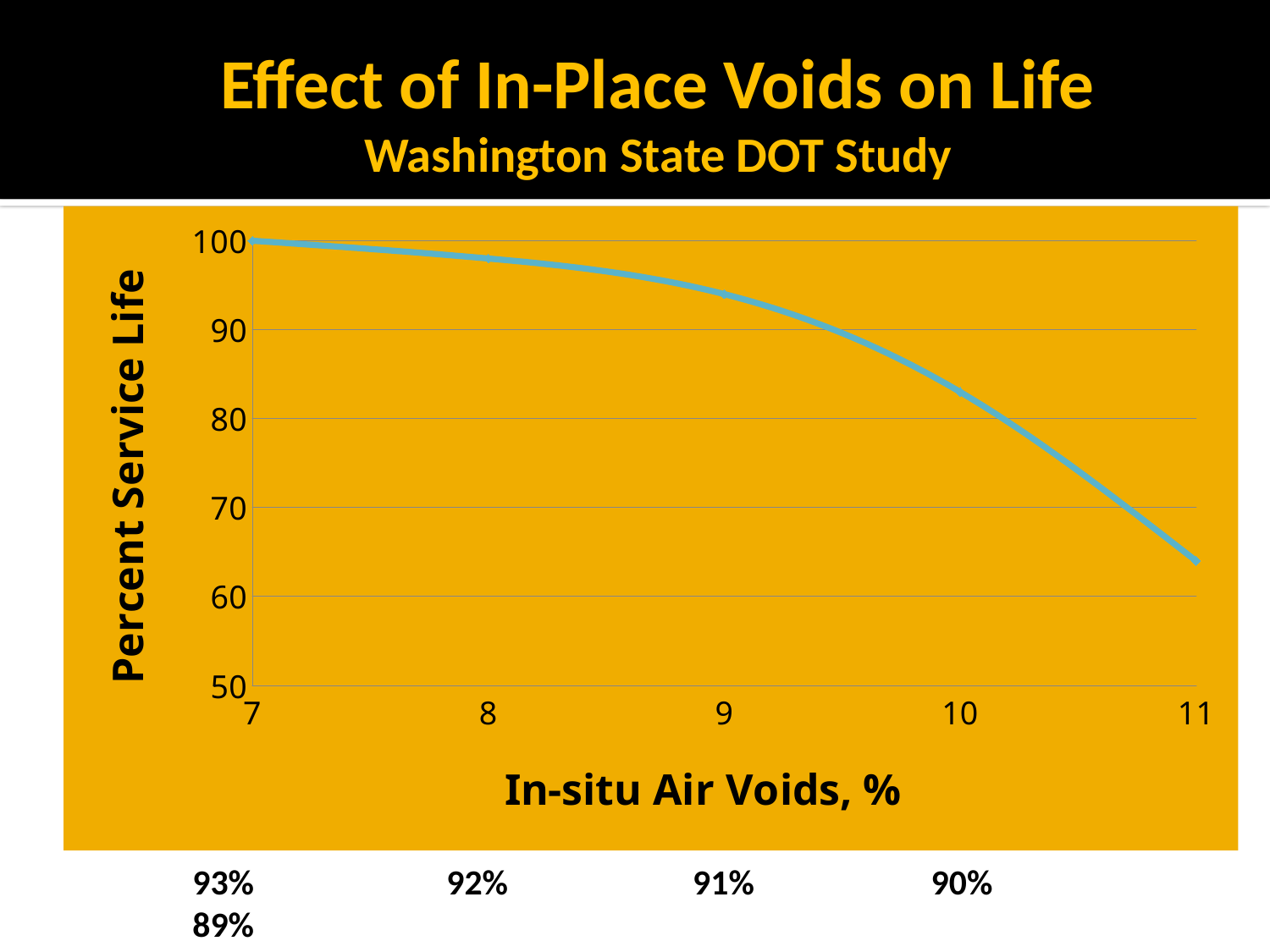
Does percent service life rise or fall as in-situ air voids increase from 7% to 11%? fall Which has a higher percent service life: 8% air voids or 10% air voids? 8% air voids Is the percent service life at 9% air voids greater or less than 90? greater What is the label on the x axis of the chart? In-situ Air Voids, % At which in-situ air void level is percent service life highest? 7 What is the label on the y axis of the chart? Percent Service Life Is the percent service life at 10% air voids greater or less than 90? less At which in-situ air void level is percent service life lowest? 11 Is the percent service life at 11% air voids greater or less than 70? less What kind of chart is shown on the slide? line chart What is the percent service life at 7% in-situ air voids? 100